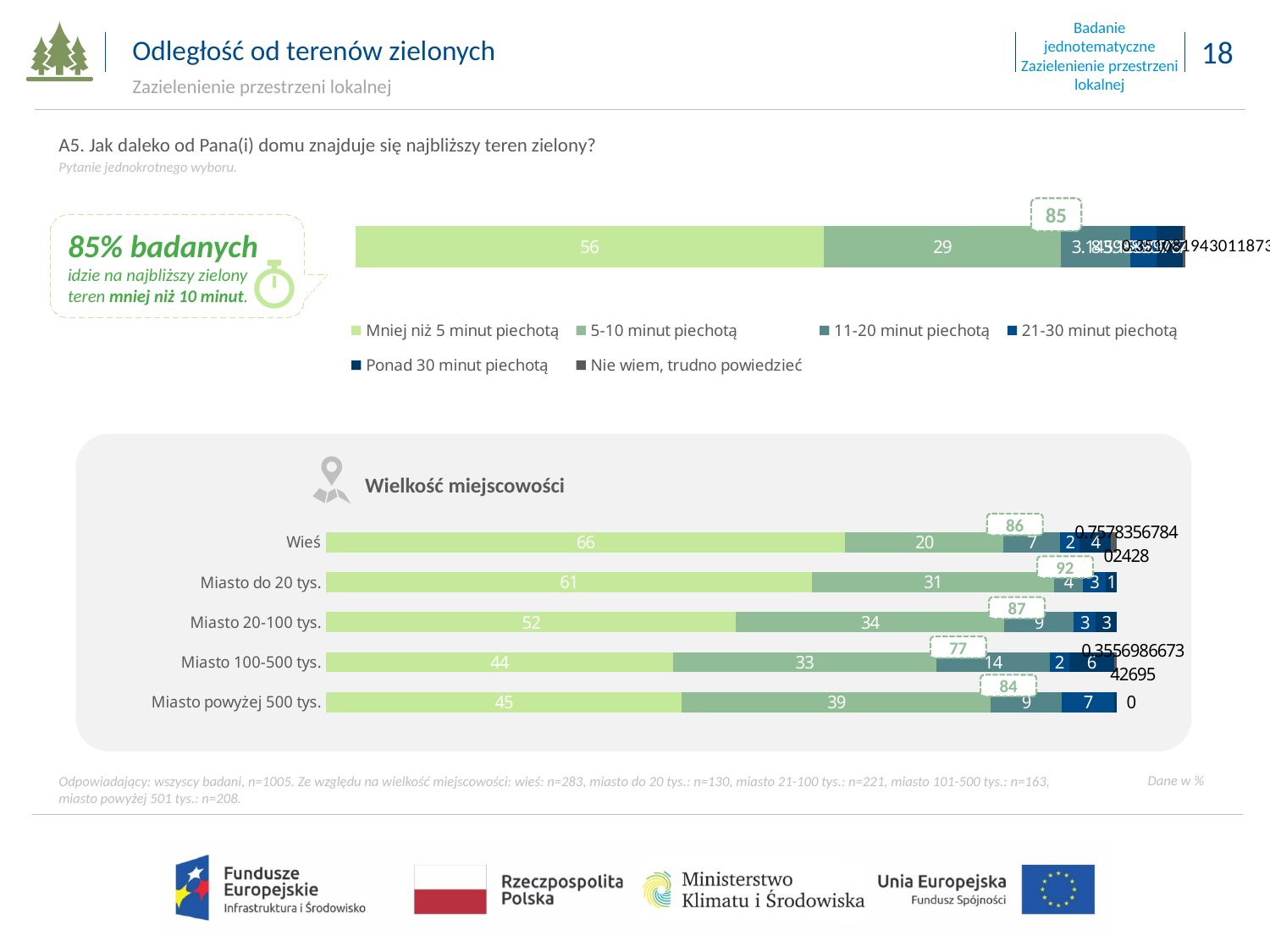
In the 'Wielkość miejscowości' chart, which category has the lowest value for 'Mniej niż 5 minut piechotą'? Miasto 100-500 tys. How many series does the legend of the top chart list? 6 In the 'Wielkość miejscowości' chart, what is the value for 'Mniej niż 5 minut piechotą' for Wieś? 66 In the 'Wielkość miejscowości' chart, which category has the highest value for 'Mniej niż 5 minut piechotą'? Wieś How many categories are shown in the 'Wielkość miejscowości' chart? 5 In the top chart, what is the value for 'Mniej niż 5 minut piechotą'? 56 In the 'Wielkość miejscowości' chart, what is the value for '5-10 minut piechotą' for Miasto powyżej 500 tys.? 39 What kind of chart is the 'Wielkość miejscowości' chart? stacked bar chart In the top chart, what is the value for '5-10 minut piechotą'? 29 In the 'Wielkość miejscowości' chart, what is the value for '11-20 minut piechotą' for Miasto 100-500 tys.? 14 In the 'Wielkość miejscowości' chart, which is larger: the '5-10 minut piechotą' value for Miasto do 20 tys. or for Wieś? Miasto do 20 tys. In the 'Wielkość miejscowości' chart, what is the difference between the 'Mniej niż 5 minut piechotą' values for Wieś and Miasto 20-100 tys.? 14